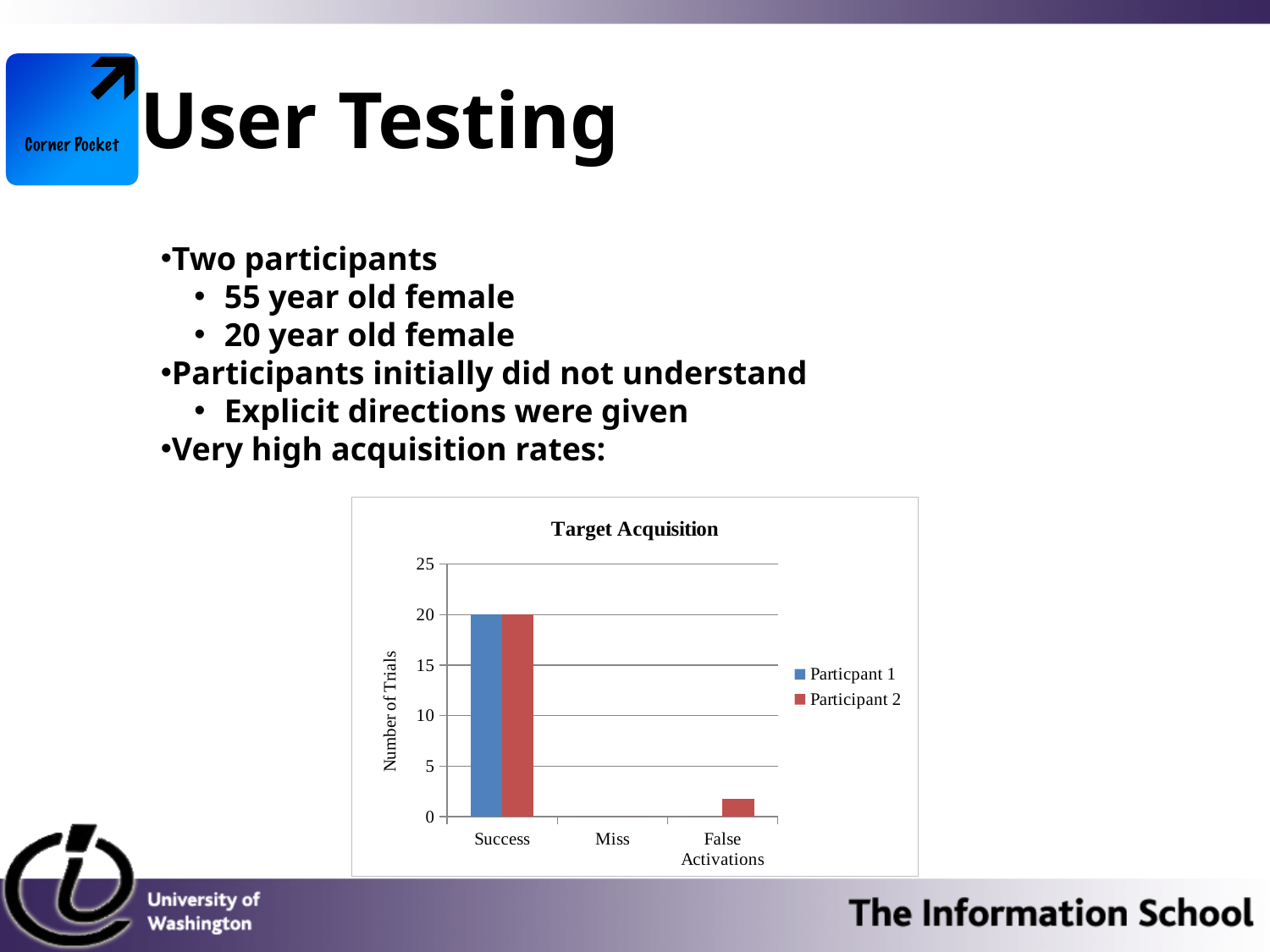
What is the label of the y axis of the chart? Number of Trials Which is larger: Participant 2's value for Success or Participant 2's value for False Activations? Success How many categories are shown on the x axis of the chart? 3 What is the value for Particpant 1 in the Success category? 20 Which series is shown in red in the chart? Participant 2 Is the value for Participant 2 in the False Activations category greater or less than 5? less Which category has the highest values in the chart? Success How many series does the chart legend list? 2 What kind of chart is shown on the slide? bar chart Is the value for Participant 2 in the Success category greater or less than 15? greater What is the title of the chart? Target Acquisition What is the value for Participant 2 in the Success category? 20